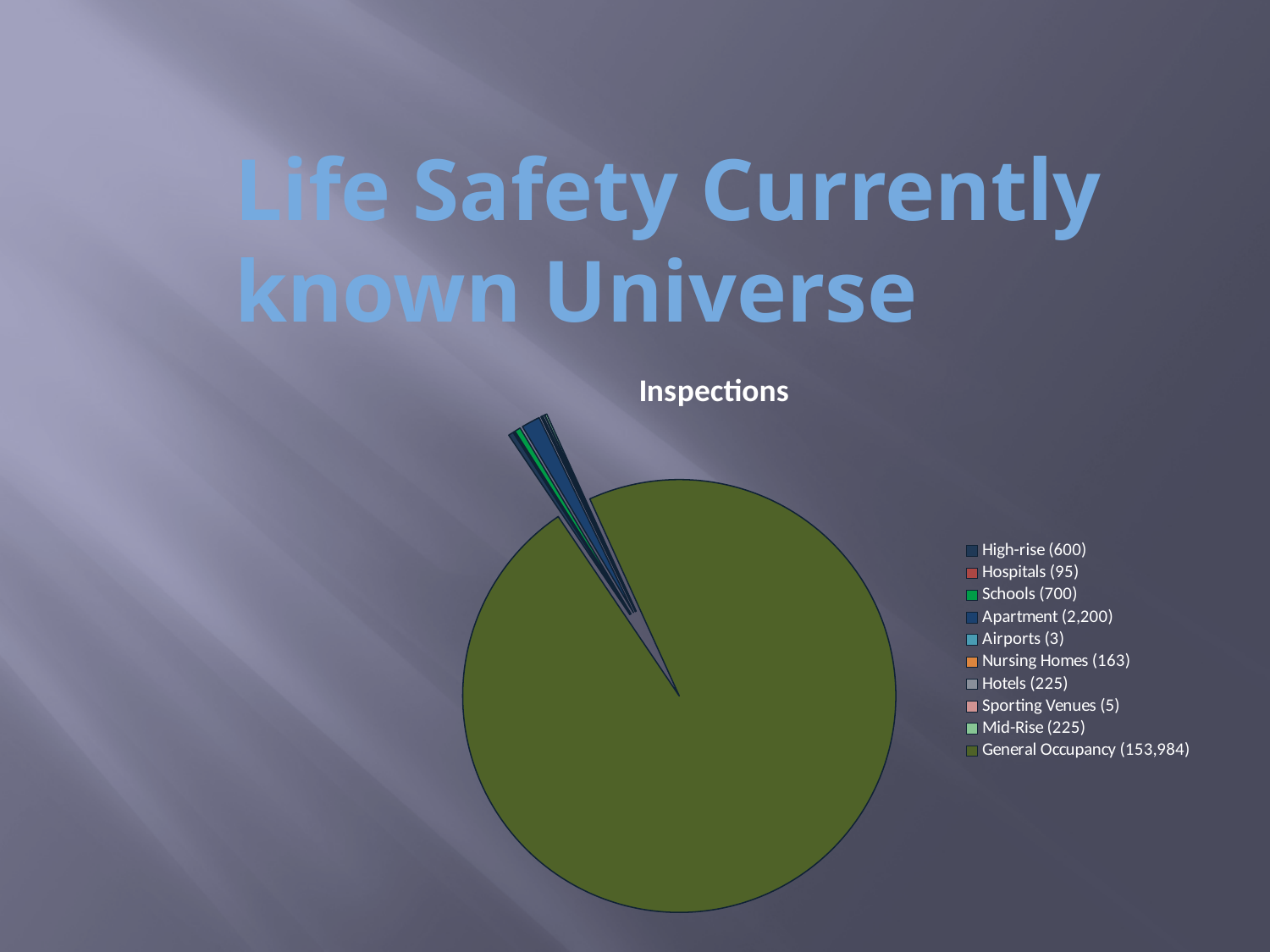
What is the value shown for Apartment? 2,200 Which is larger, the value for Hospitals or the value for Nursing Homes? Nursing Homes What is the value shown for Nursing Homes? 163 What is the title of the chart? Inspections What is the difference between the Apartment value and the High-rise value? 1,600 What is the value shown for General Occupancy? 153,984 How many categories does the pie chart's legend list? 10 What is the difference between the Schools value and the High-rise value? 100 What kind of chart is shown on the slide? Pie chart Which category has the largest slice of the pie? General Occupancy Which category has the smallest value? Airports What is the value shown for Airports? 3